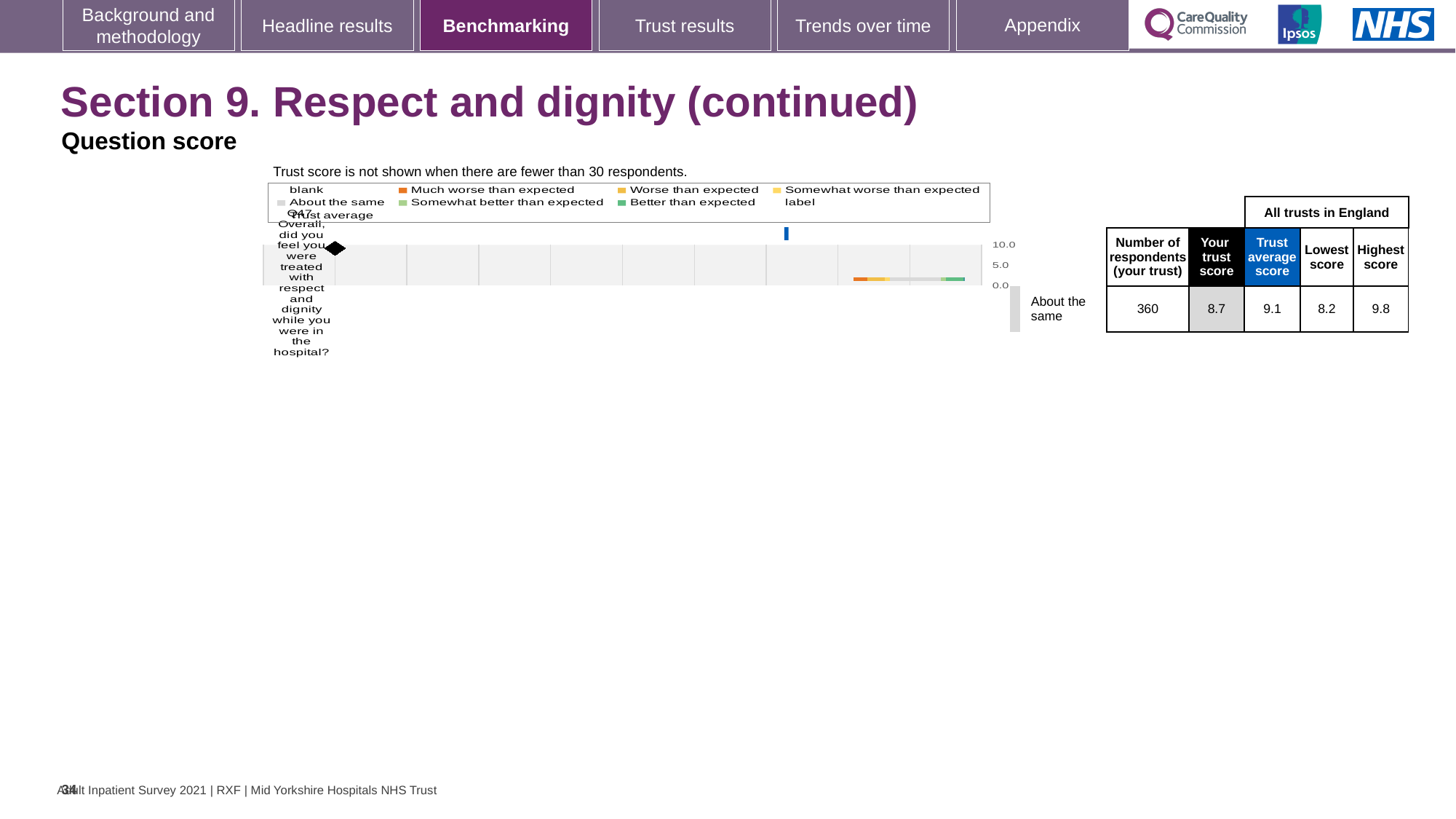
According to the table next to the chart, what is the number of respondents for your trust for Q47? 360 According to the table next to the chart, what is the lowest score among all trusts in England for Q47? 8.2 What is the highest tick value shown on the chart's score axis? 10.0 What kind of chart is shown on the slide? bar chart According to the table next to the chart, what is the highest score among all trusts in England for Q47? 9.8 Which question number is plotted on the chart? Q47 What is the difference between the highest score and the lowest score for Q47? 1.6 How many questions (categories) are plotted on the chart? 1 According to the table next to the chart, what is your trust score for Q47? 8.7 What benchmarking category label is shown for Q47 beside the chart? About the same According to the table next to the chart, what is the trust average score for Q47? 9.1 Which is larger for Q47: your trust score or the trust average score? Trust average score